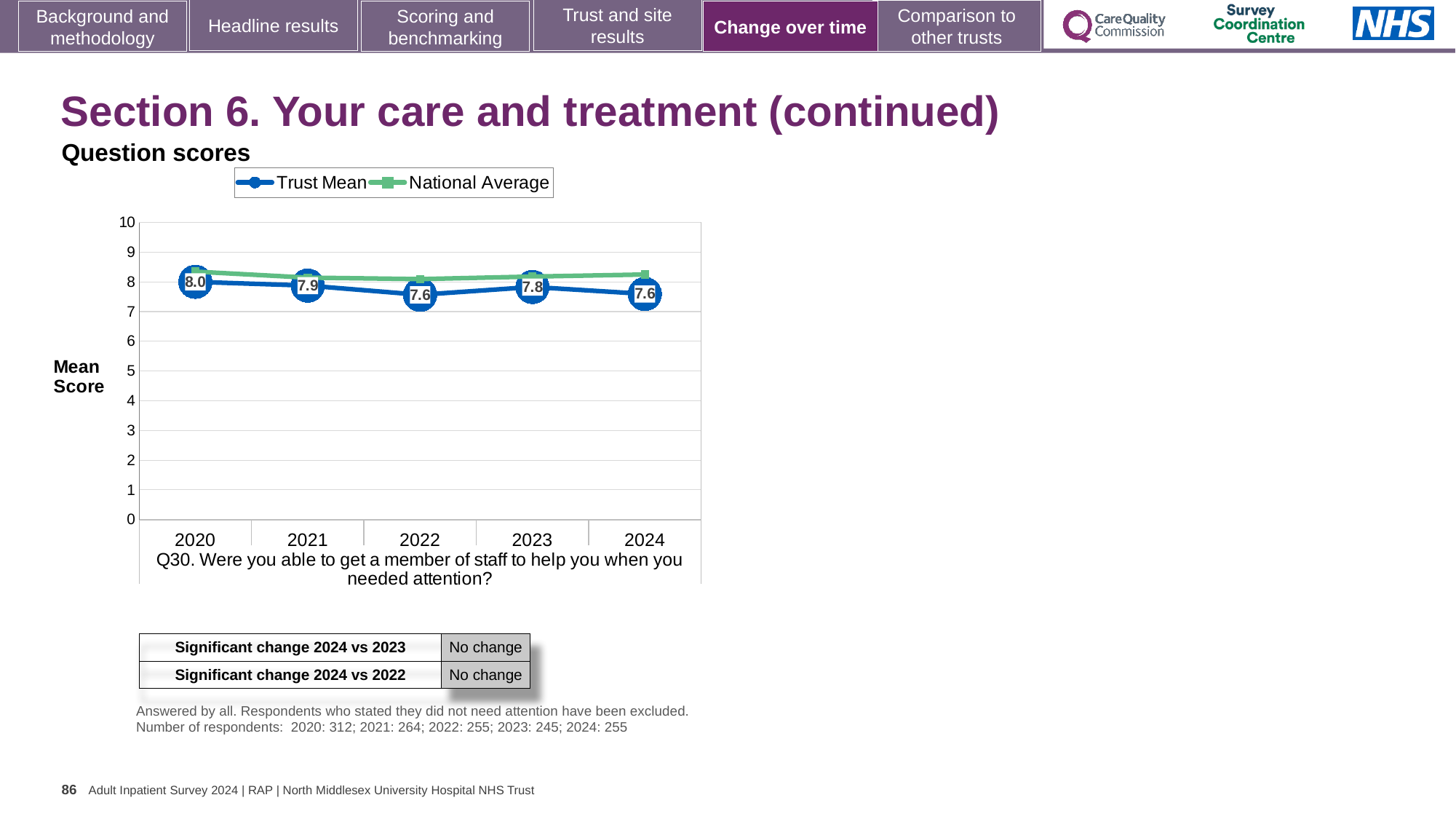
What are the two series named in the legend? Trust Mean and National Average What is the Trust Mean value for 2022? 7.6 What is the Trust Mean value for 2020? 8.0 Which is larger, the Trust Mean for 2021 or for 2023? 2021 How many years are plotted on the x axis? 5 In which year is the Trust Mean highest? 2020 How many series does the legend list? 2 Is the National Average value for 2024 greater or less than 8? greater What kind of chart is shown? line chart What is the difference between the Trust Mean in 2020 and in 2024? 0.4 Does the Trust Mean rise or fall from 2020 to 2024? fall What is the Trust Mean value for 2023? 7.8